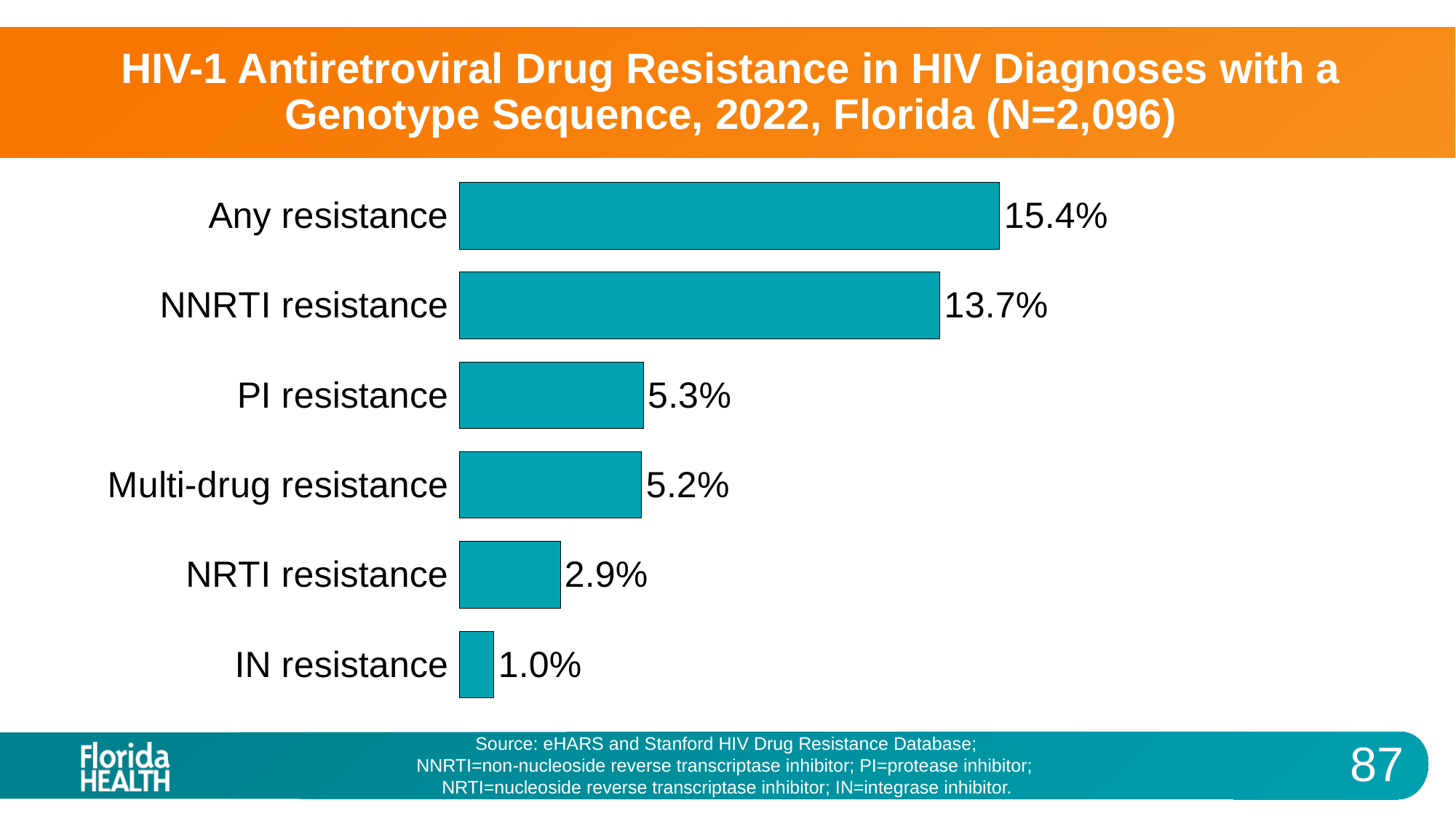
What kind of chart is shown on the slide? Bar chart What is the value for Any resistance? 15.4% Which category has the highest value? Any resistance What is the difference between Any resistance and NNRTI resistance? 1.7% Which category has the lowest value? IN resistance How many categories are shown in the chart? 6 What is the value for NRTI resistance? 2.9% What is the value for IN resistance? 1.0% What colour are the bars in the chart? Teal What is the difference between PI resistance and NRTI resistance? 2.4% What is the value for NNRTI resistance? 13.7% Which is larger, NNRTI resistance or NRTI resistance? NNRTI resistance